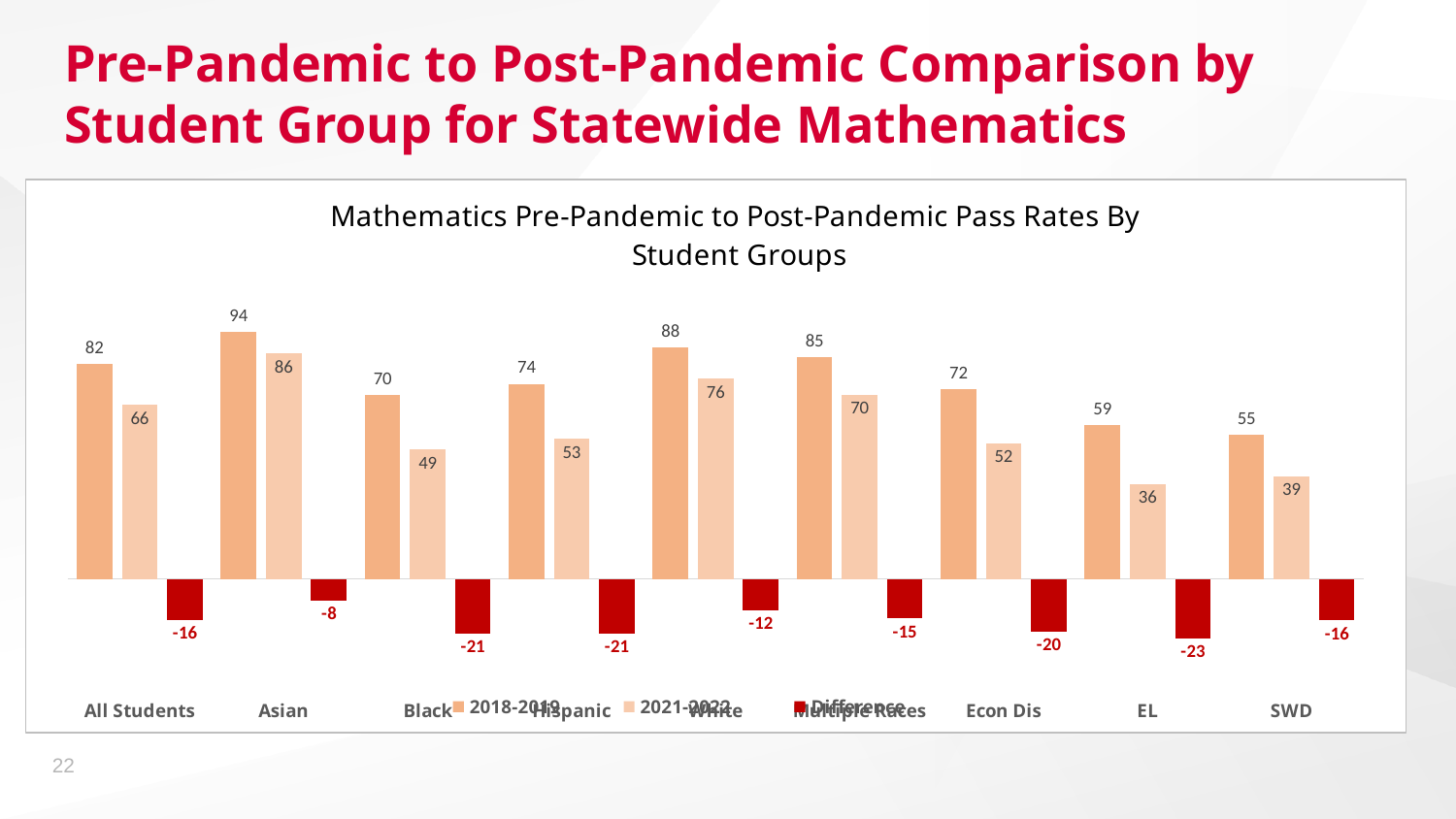
How many series does the legend list? 3 How many student groups are shown on the x axis? 9 Which student group has the largest negative Difference value? EL What is the 2021-2022 pass rate for EL students? 36 What is the difference between the 2018-2019 and 2021-2022 pass rates for Black students? 21 What kind of chart is shown on the slide? Bar chart What is the title of the chart? Mathematics Pre-Pandemic to Post-Pandemic Pass Rates By Student Groups Which student group has the lowest 2018-2019 pass rate? SWD What is the 2018-2019 pass rate for Asian students? 94 What is the Difference value shown for Hispanic students? -21 Which is larger, the 2021-2022 pass rate for White students or for Multiple Races students? White Which student group has the highest 2021-2022 pass rate? Asian